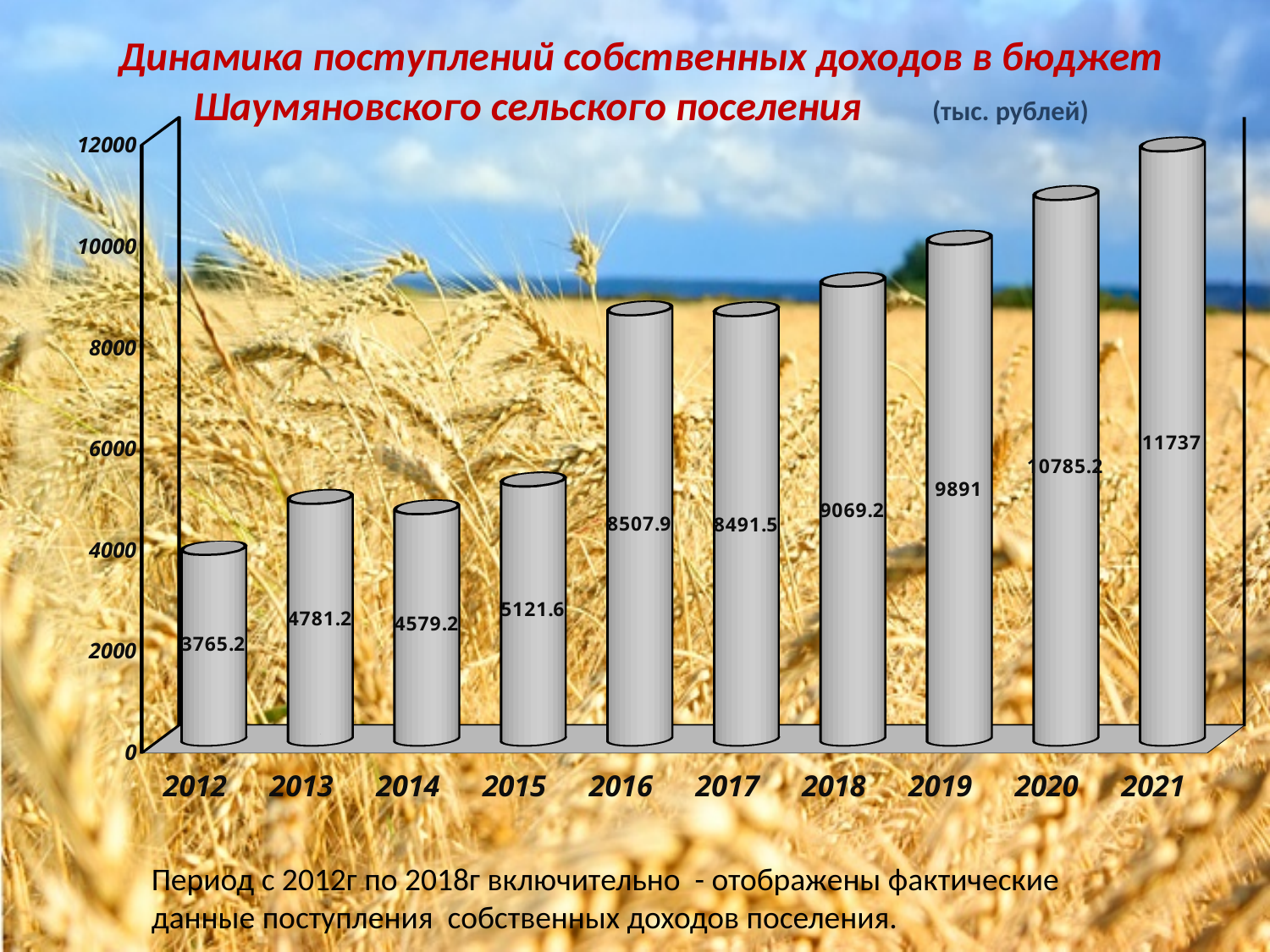
Which year has the highest value? 2021 What is the value for 2012? 3765.2 What unit is given in the chart title? тыс. рублей Which is larger, the value for 2013 or the value for 2015? 2015 How many years are shown on the x axis? 10 Is the value for 2019 greater or less than 8000? greater Which year has the lowest value? 2012 What kind of chart is shown on the slide? bar chart What is the difference between the values for 2013 and 2014? 202 What is the value for 2020? 10785.2 What is the difference between the values for 2021 and 2020? 951.8 What is the value for 2017? 8491.5